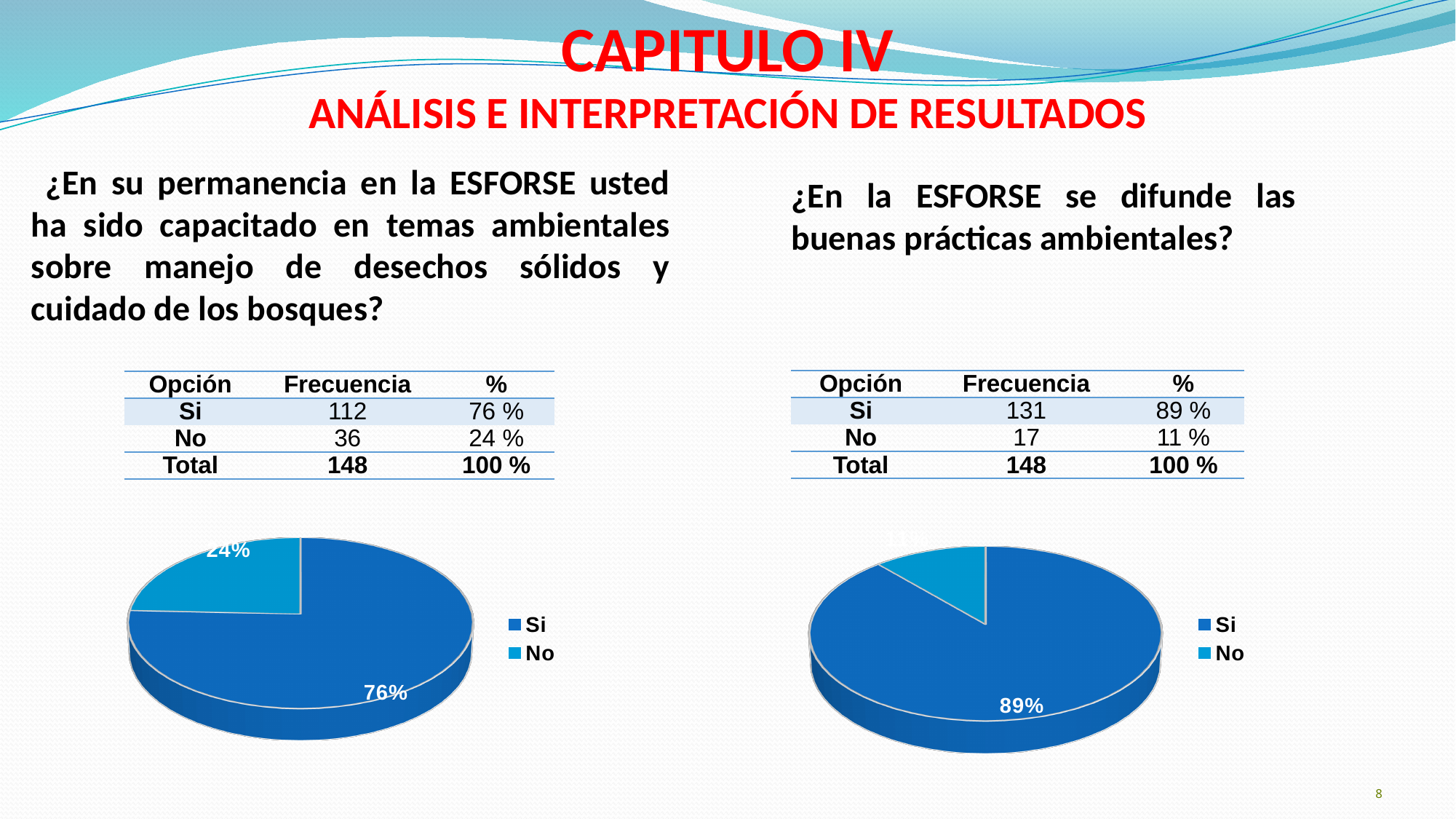
In the left pie chart, what share of the pie does the Si slice represent? 76% How many entries does the legend of the right pie chart list? 2 What kind of chart is shown on the right side of the slide? pie chart In the right pie chart, which slice is the smallest? No In the left pie chart, what share of the pie does the No slice represent? 24% In the left pie chart, what is the difference in percentage points between the Si slice and the No slice? 52 What are the legend entries of the left pie chart? Si, No How many slices does the left pie chart have? 2 In the left pie chart, which slice is the largest? Si What kind of chart is shown on the left side of the slide? pie chart In the right pie chart, what share of the pie does the Si slice represent? 89% In the right pie chart, is the Si slice larger or smaller than the No slice? larger